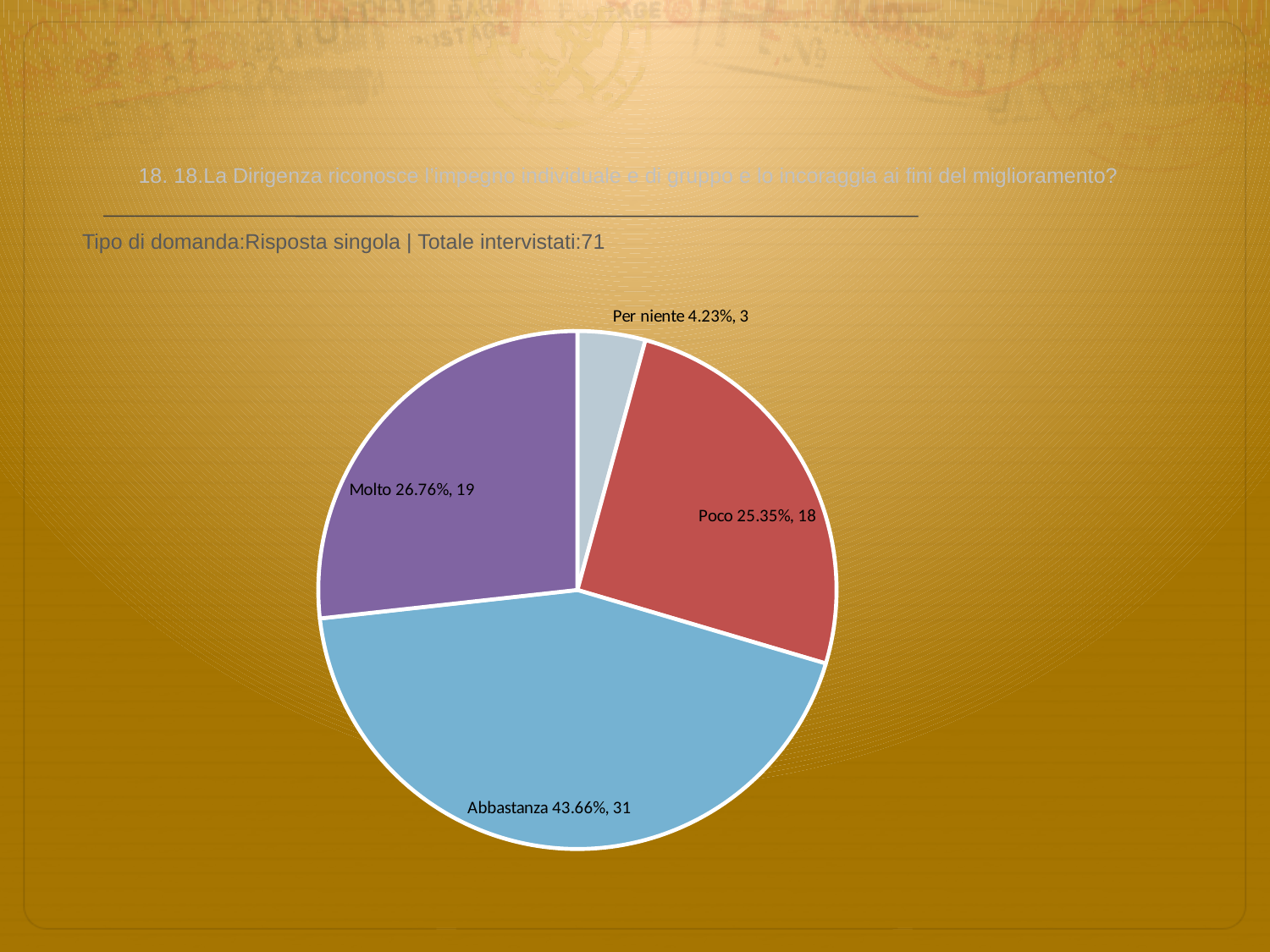
What kind of chart is shown on the slide? pie chart What percentage share does the Poco slice have? 25.35% How many slices does the pie chart have? 4 How many respondents answered Per niente? 3 Which category has the largest slice? Abbastanza What percentage share does the Abbastanza slice have? 43.66% What colour is the Abbastanza slice? blue What is the total number of respondents across all slices? 71 Which has more respondents, Molto or Poco? Molto How many respondents answered Molto? 19 Which category has the smallest slice? Per niente What is the difference in respondent count between Abbastanza and Poco? 13